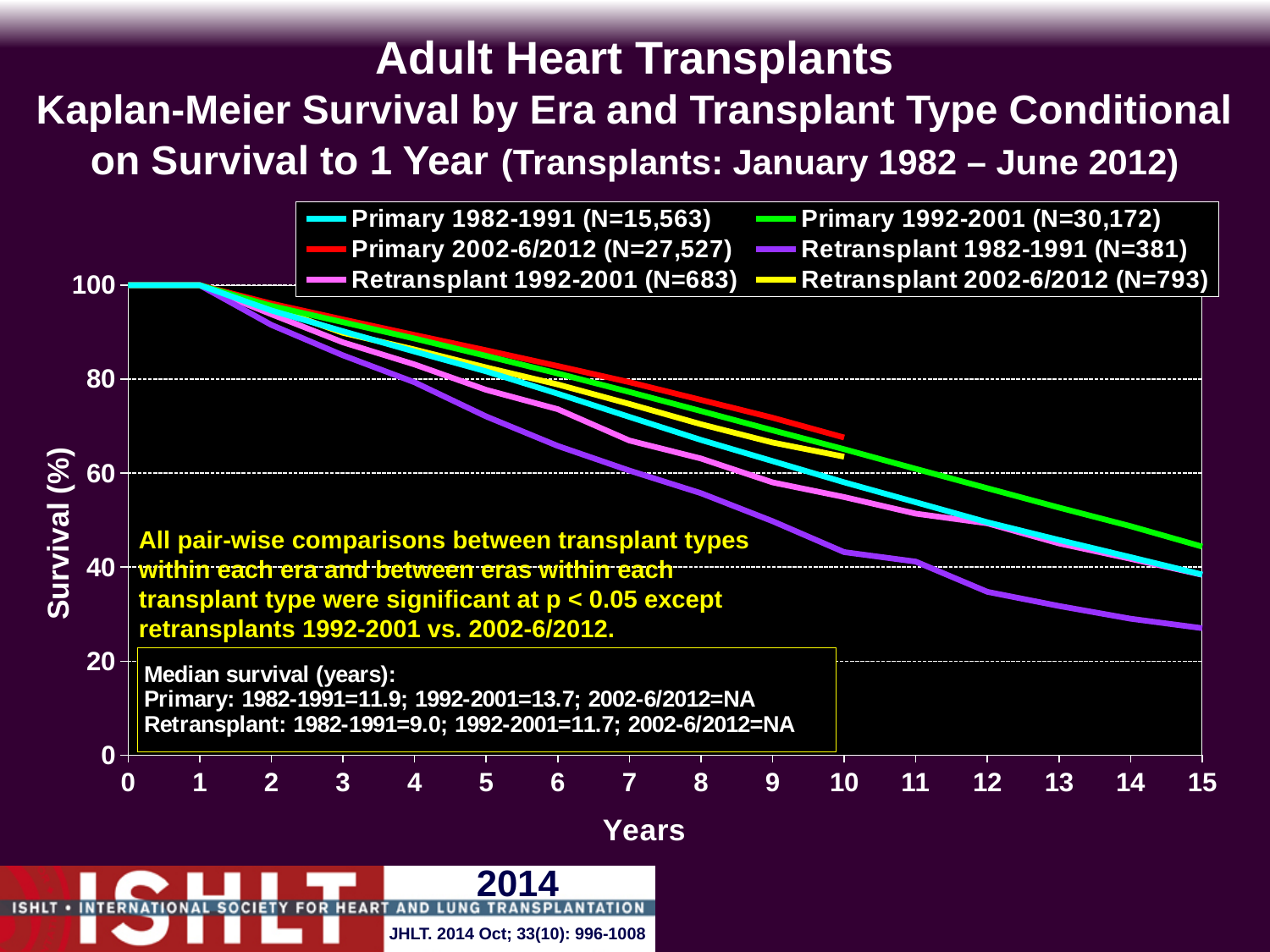
Is the survival for Primary 1992-2001 at 15 years greater or less than 40%? greater What is the N for the Primary 1992-2001 series in the legend? 30,172 Which series has the highest survival at 15 years? Primary 1992-2001 Is the survival for Retransplant 1982-1991 at 15 years greater or less than 40%? less Do the survival curves rise or fall as years since transplant increase? Fall What is the median survival in years for Primary transplants in 1992-2001? 13.7 What kind of chart is shown on the slide? Line chart Which series has the lowest survival at 15 years? Retransplant 1982-1991 How many series does the legend list? 6 At 10 years, which has higher survival: Primary 2002-6/2012 or Retransplant 2002-6/2012? Primary 2002-6/2012 What is the median survival in years for Retransplants in 1982-1991? 9.0 Is the survival for Primary 2002-6/2012 at 10 years greater or less than 60%? greater